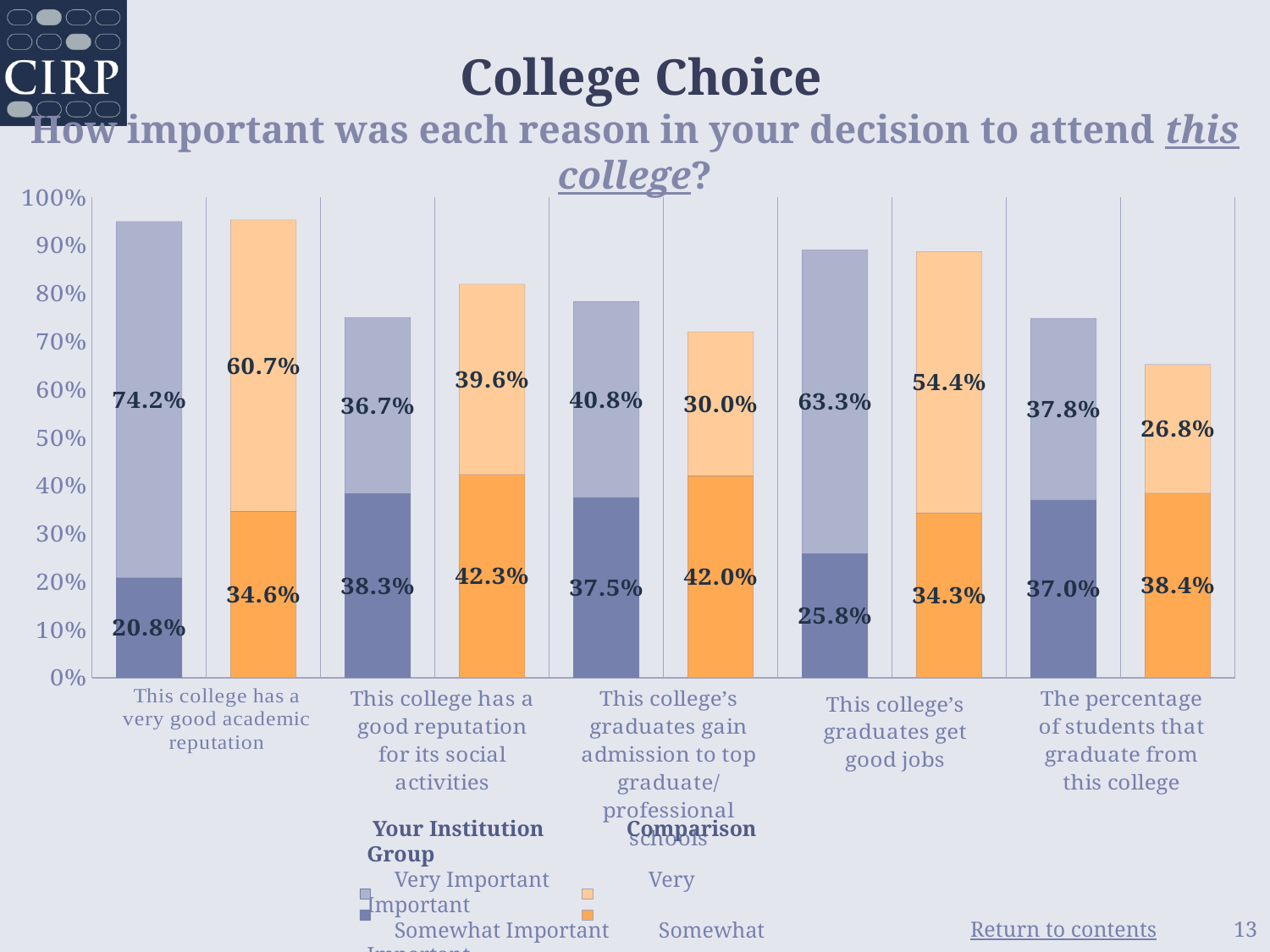
What is the total of the stacked bar for the Comparison Group for 'This college's graduates get good jobs'? 88.7% What percentage of students at Your Institution rated 'The percentage of students that graduate from this college' as Somewhat Important? 37.0% What is the difference between the Very Important percentages for Your Institution and the Comparison Group for 'This college's graduates get good jobs'? 8.9% Which reason has the lowest Very Important percentage for the Comparison Group? The percentage of students that graduate from this college What percentage of students at Your Institution rated 'This college has a very good academic reputation' as Very Important? 74.2% What kind of chart is shown on the slide? Stacked bar chart What percentage of the Comparison Group rated 'This college's graduates get good jobs' as Somewhat Important? 34.3% What is the total of the stacked bar for Your Institution for 'This college has a very good academic reputation'? 95.0% How many reasons (categories) are shown on the x axis of the chart? 5 How many series does the chart legend list? 4 Which reason has the highest Very Important percentage for Your Institution? This college has a very good academic reputation For 'This college's graduates gain admission to top graduate/professional schools', which group has the larger Very Important percentage, Your Institution or the Comparison Group? Your Institution